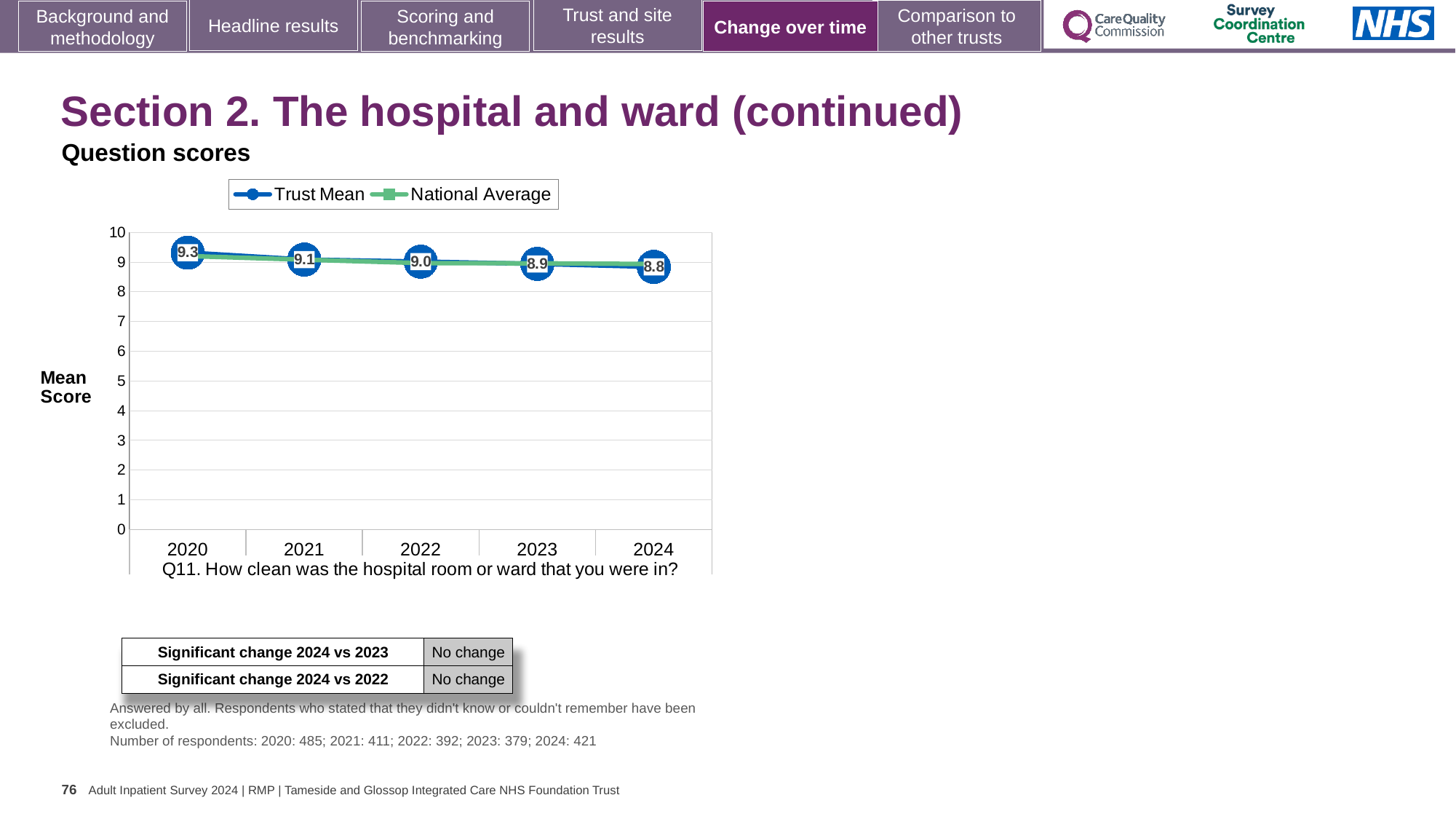
In which year is the Trust Mean lowest? 2024 How many years are shown on the x axis? 5 How many series does the legend list? 2 What is the Trust Mean value for 2020? 9.3 Does the Trust Mean rise or fall from 2020 to 2024? Fall What is the difference between the Trust Mean in 2020 and in 2024? 0.5 What kind of chart is shown? Line chart What is the Trust Mean value for 2024? 8.8 What is the Trust Mean value for 2022? 9.0 Is the National Average value for 2024 greater or less than 8? greater In which year is the Trust Mean highest? 2020 Which year has a larger Trust Mean, 2021 or 2023? 2021